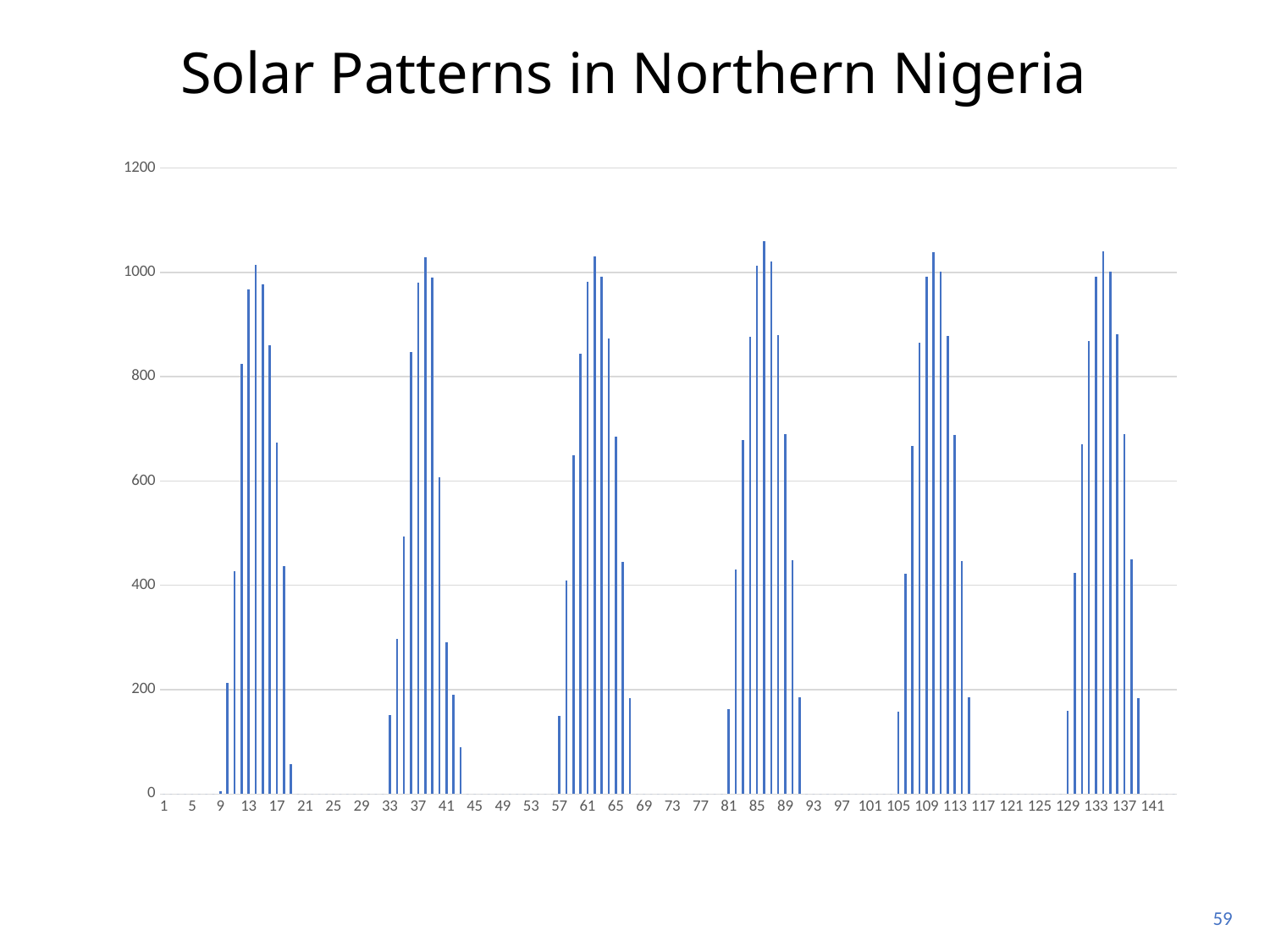
Is the value at x = 17 greater or less than 800? less How many separate clusters of bars appear along the x axis? 6 Is the value at x = 9 greater or less than 200? less What is the last label shown on the horizontal axis? 141 What is the highest value labelled on the vertical axis? 1200 Is the value at x = 25 greater or less than 200? less What is the title of the chart? Solar Patterns in Northern Nigeria What kind of chart is shown on the slide? bar chart